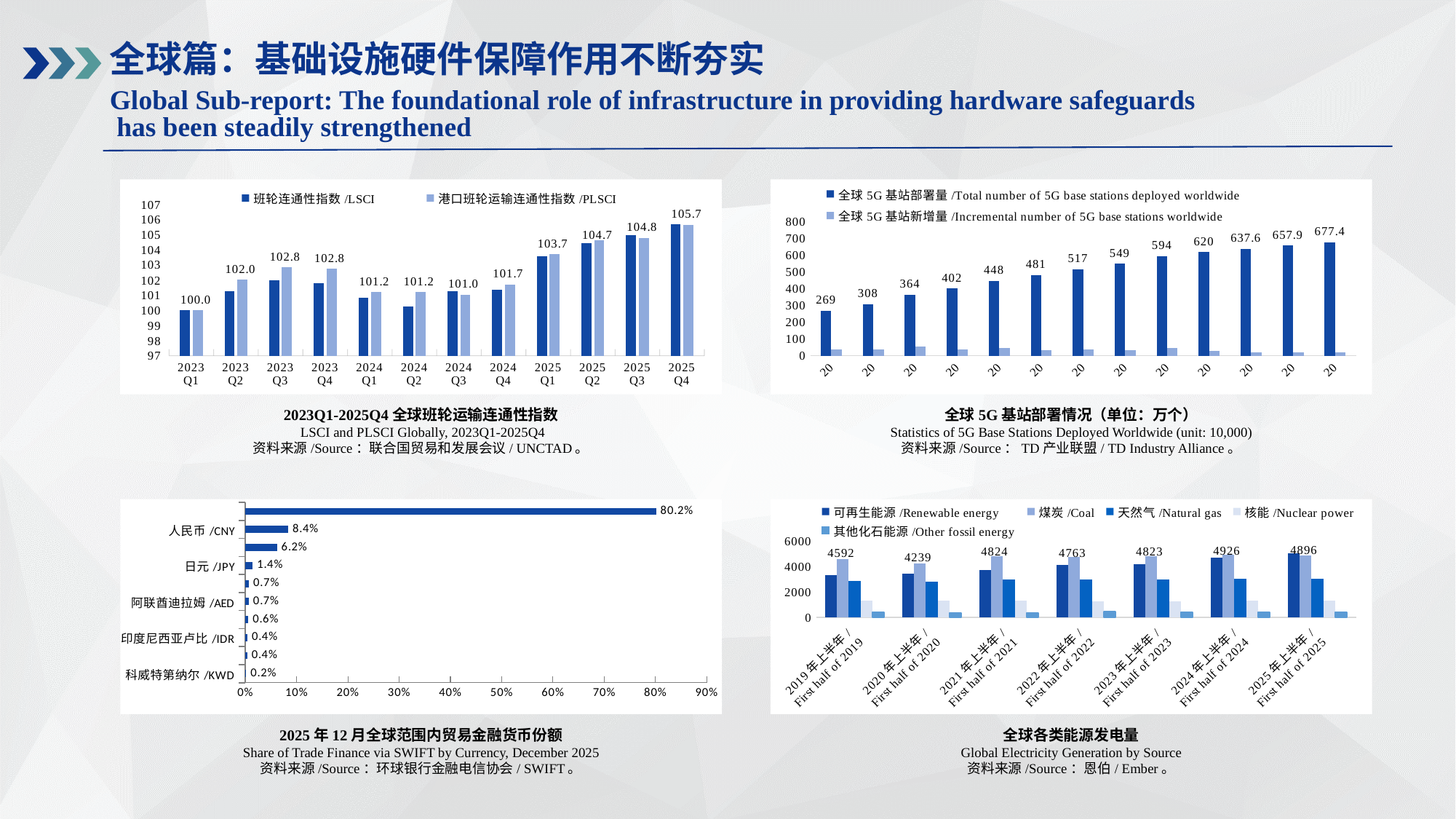
In the top-left chart (LSCI and PLSCI Globally), do the labelled values rise or fall from 2025 Q1 to 2025 Q4? rise In the top-left chart (LSCI and PLSCI Globally), how many series does the legend list? 2 In the top-right chart (Statistics of 5G Base Stations Deployed Worldwide), what is the difference between the highest labelled value (677.4) and the lowest labelled value (269)? 408.4 In the bottom-right chart (Global Electricity Generation by Source), how many series does the legend list? 5 In the top-left chart (LSCI and PLSCI Globally), what is the highest labelled value and in which quarter does it occur? 105.7, 2025 Q4 In the bottom-left chart (Share of Trade Finance via SWIFT by Currency), which is larger, the share for 人民币/CNY or for 日元/JPY? 人民币/CNY In the top-left chart (LSCI and PLSCI Globally), how many quarters are shown on the x axis? 12 In the bottom-left chart (Share of Trade Finance via SWIFT by Currency), what is the share for 人民币/CNY? 8.4% In the top-right chart (Statistics of 5G Base Stations Deployed Worldwide), are the incremental (light blue) bars greater or less than 100? less In the bottom-left chart (Share of Trade Finance via SWIFT by Currency), what kind of chart is it? horizontal bar chart In the bottom-right chart (Global Electricity Generation by Source), what is the labelled value for First half of 2024? 4926 In the top-right chart (Statistics of 5G Base Stations Deployed Worldwide), what is the highest labelled value? 677.4